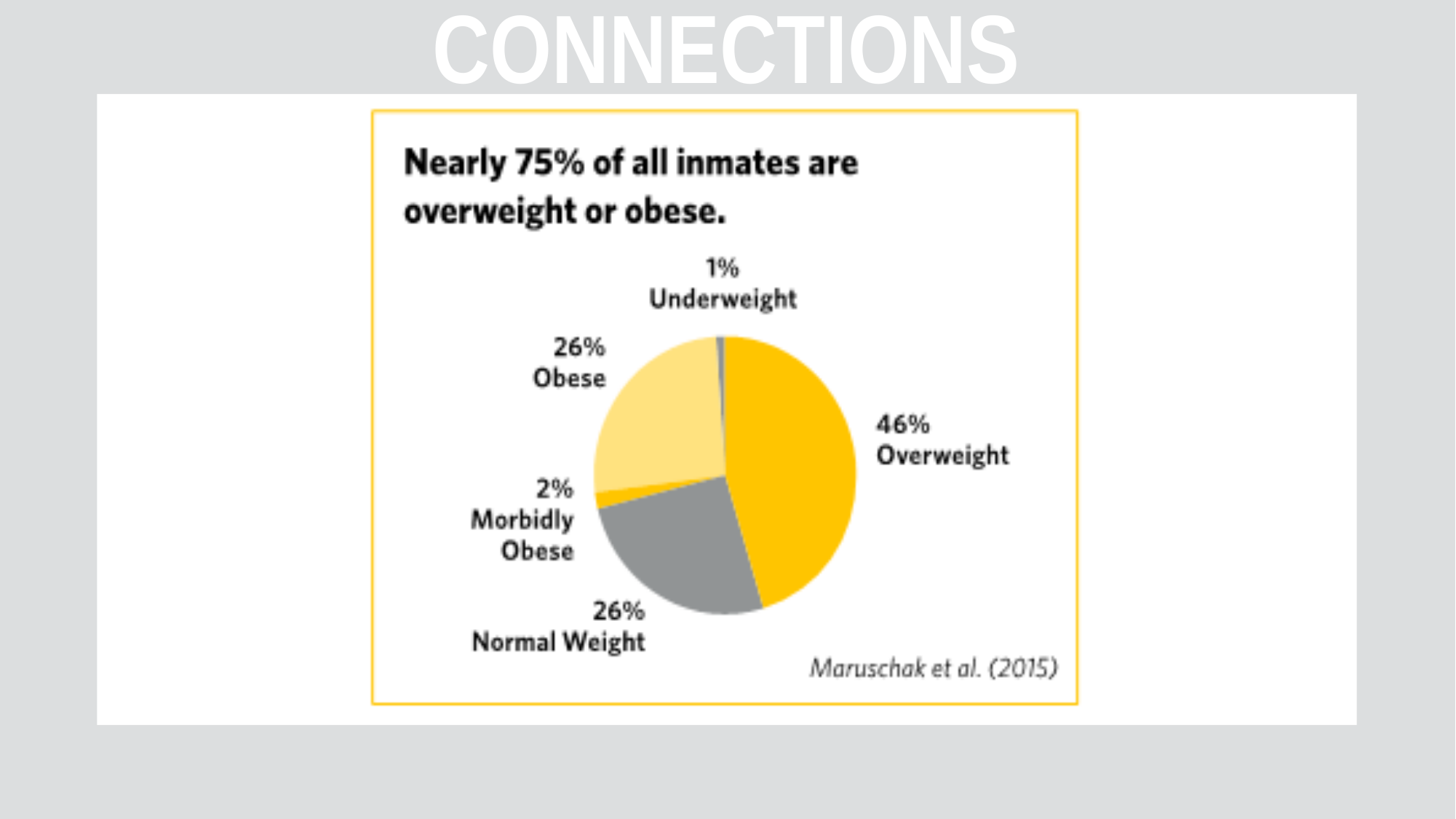
Which category has the largest share of the pie? Overweight What percentage of inmates are Normal Weight? 26% What percentage of inmates are Obese? 26% What percentage of inmates are Underweight? 1% How many categories are shown in the pie chart? 5 What kind of chart is shown on the slide? pie chart What percentage of inmates are Morbidly Obese? 2% Which category has the smallest share of the pie? Underweight Which is larger, the Morbidly Obese share or the Underweight share? Morbidly Obese What is the difference between the Overweight share and the Obese share? 20% What percentage of inmates are Overweight? 46% What is the title of the chart? Nearly 75% of all inmates are overweight or obese.